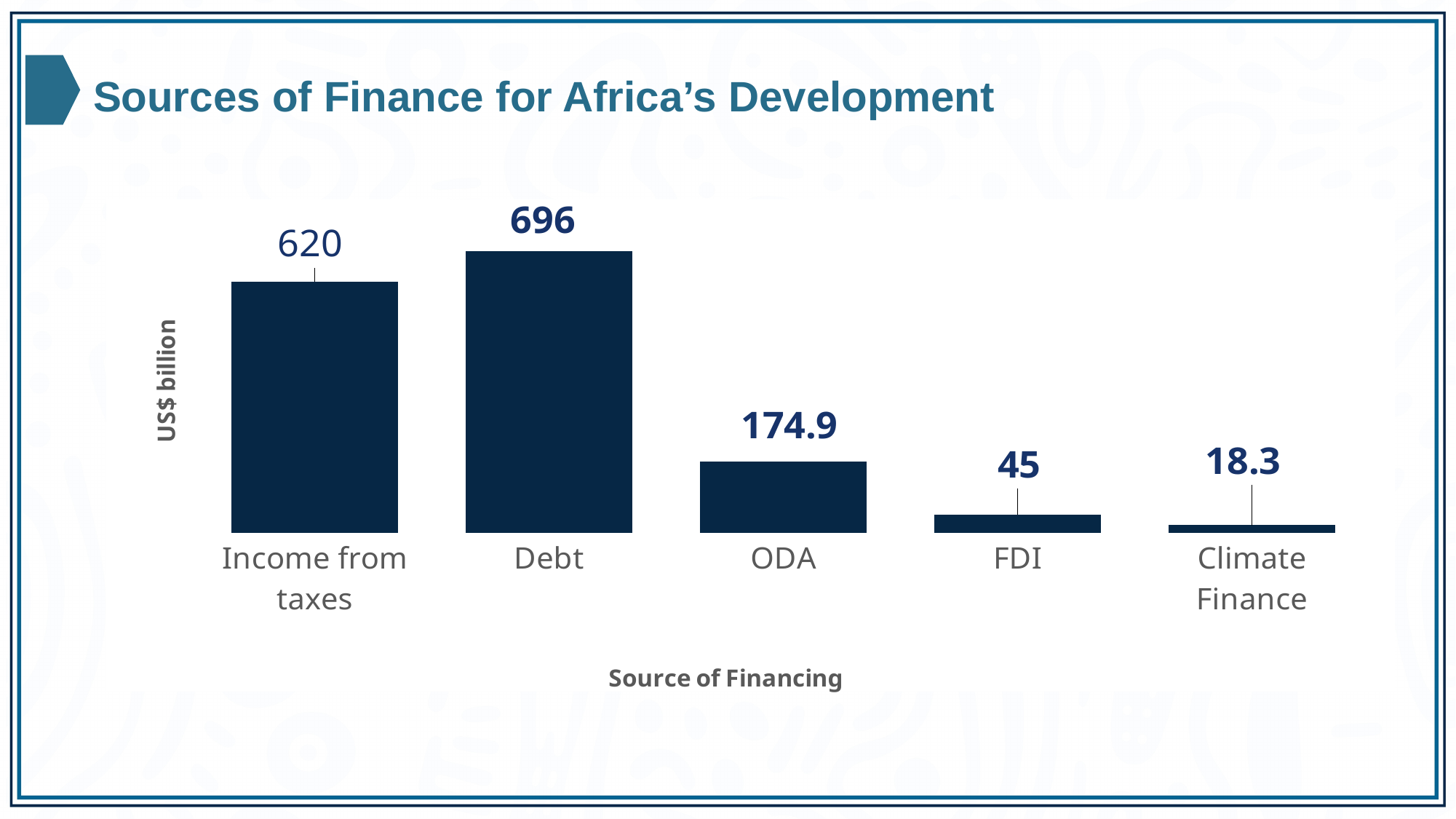
Which source of financing has the highest value? Debt What is the value for Climate Finance? 18.3 What is the value for ODA? 174.9 What is the value for Income from taxes? 620 Which is larger, the value for ODA or the value for FDI? ODA What kind of chart is shown on the slide? Bar chart What is the label of the vertical axis? US$ billion What is the difference between the values for Debt and Income from taxes? 76 What is the value for Debt? 696 Which source of financing has the lowest value? Climate Finance How many sources of financing are shown in the chart? 5 What is the difference between the values for FDI and Climate Finance? 26.7